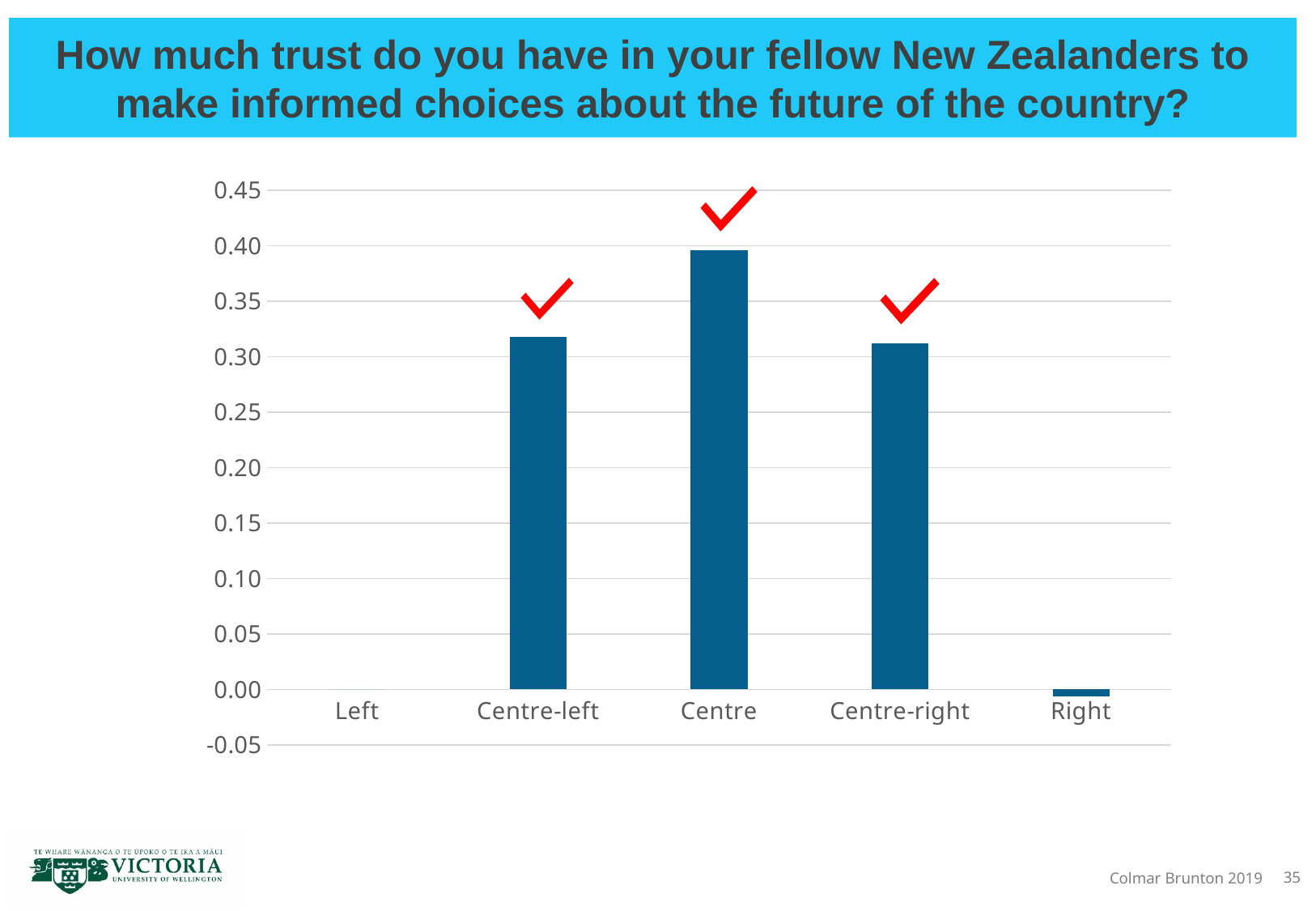
What kind of chart is shown on the slide? bar chart Is the value for Centre-right greater or less than 0.35? less Is the value for Right greater or less than 0.05? less Is the value for Centre-left greater or less than 0.35? less How many bars in the chart have a red check mark above them? 3 Which is larger, the value for Centre or the value for Centre-right? Centre How many categories are shown on the x axis of the chart? 5 What is the highest tick value shown on the vertical axis of the chart? 0.45 Which category has the highest value in the chart? Centre